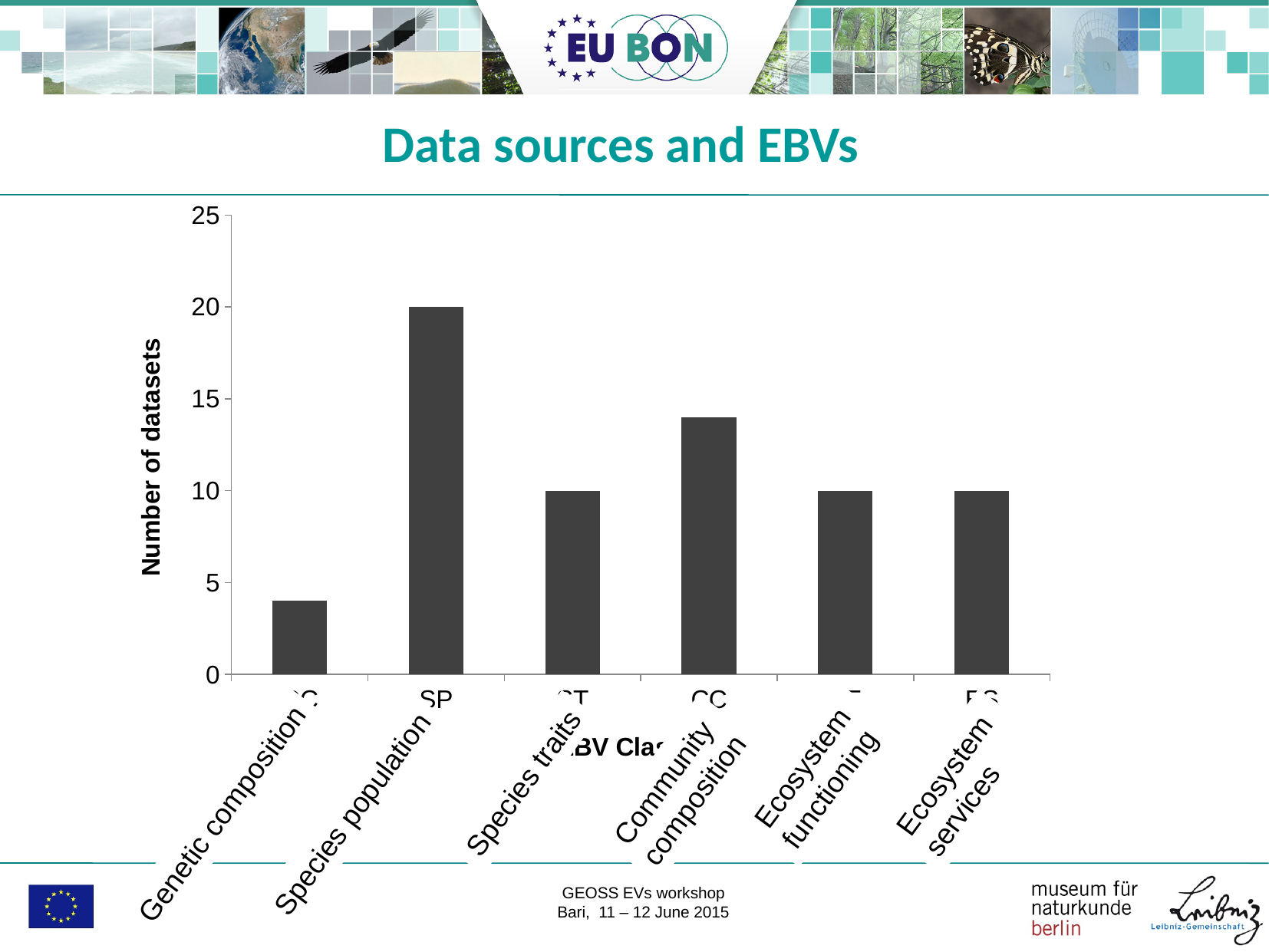
Which has more datasets, Community composition or Species traits? Community composition What is the label of the y-axis? Number of datasets How many EBV classes (categories) are plotted in the chart? 6 What is the number of datasets for Species traits? 10 Which EBV class has the lowest number of datasets? Genetic composition Is the number of datasets for Genetic composition greater or less than 5? less Which EBV class has the highest number of datasets? Species population What kind of chart is shown on the slide? bar chart What is the number of datasets for Species population? 20 What is the number of datasets for Ecosystem services? 10 Is the number of datasets for Community composition greater or less than 15? less What is the difference in number of datasets between Species population and Ecosystem functioning? 10